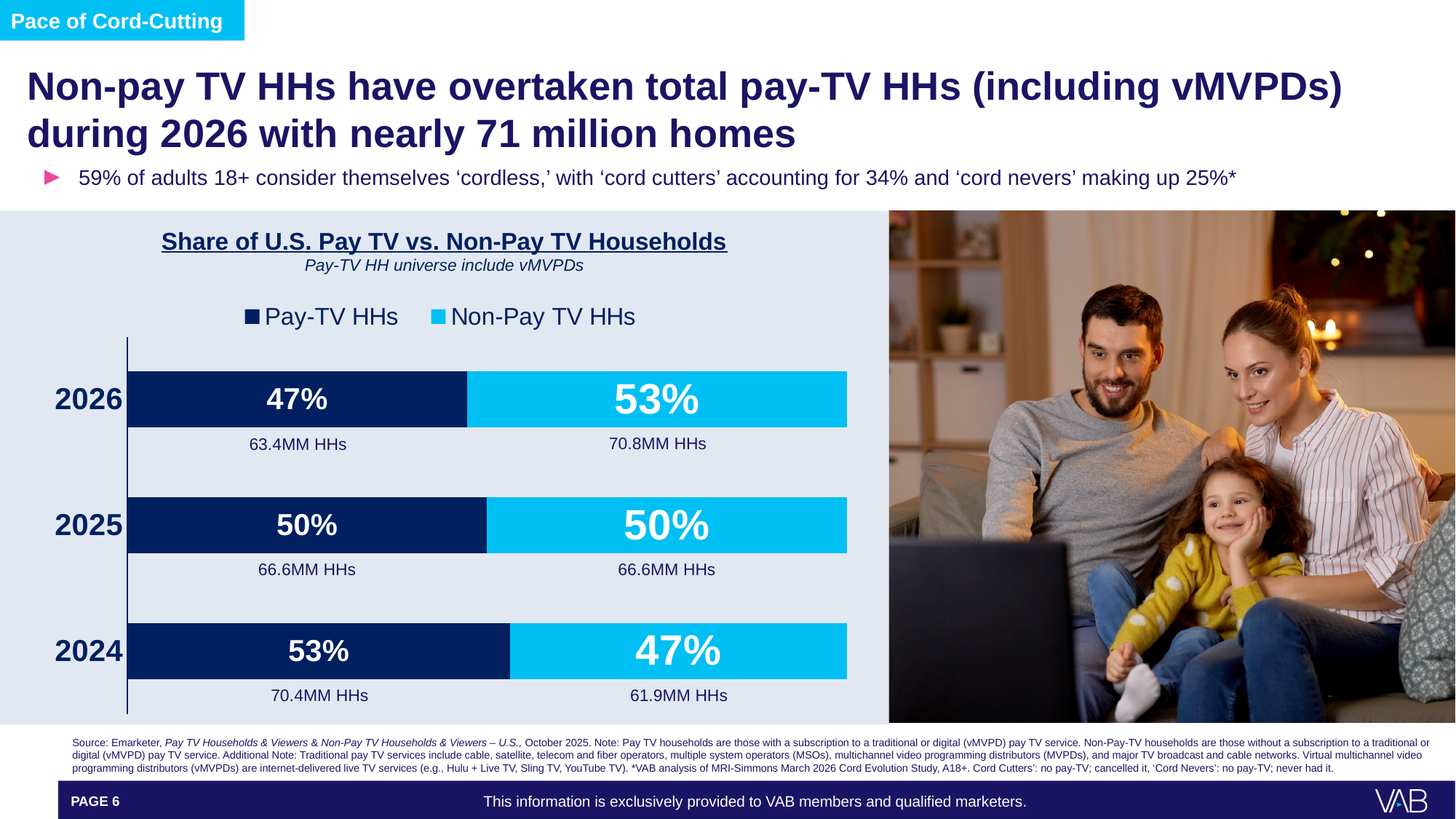
What is the title of the chart? Share of U.S. Pay TV vs. Non-Pay TV Households How many households (in MM) are Pay-TV HHs in 2024? 70.4MM HHs How many households (in MM) are Non-Pay TV HHs in 2026? 70.8MM HHs What is the Non-Pay TV HHs share for 2024? 47% What kind of chart is shown on the slide? Stacked bar chart What is the Pay-TV HHs share for 2026? 47% Which is larger in 2024, the Pay-TV HHs share or the Non-Pay TV HHs share? Pay-TV HHs In which year is the Pay-TV HHs share highest? 2024 In which year is the Non-Pay TV HHs share lowest? 2024 How many series does the legend list? 2 What is the difference in percentage points between the Non-Pay TV HHs share and the Pay-TV HHs share in 2026? 6 percentage points How many years are shown in the chart? 3